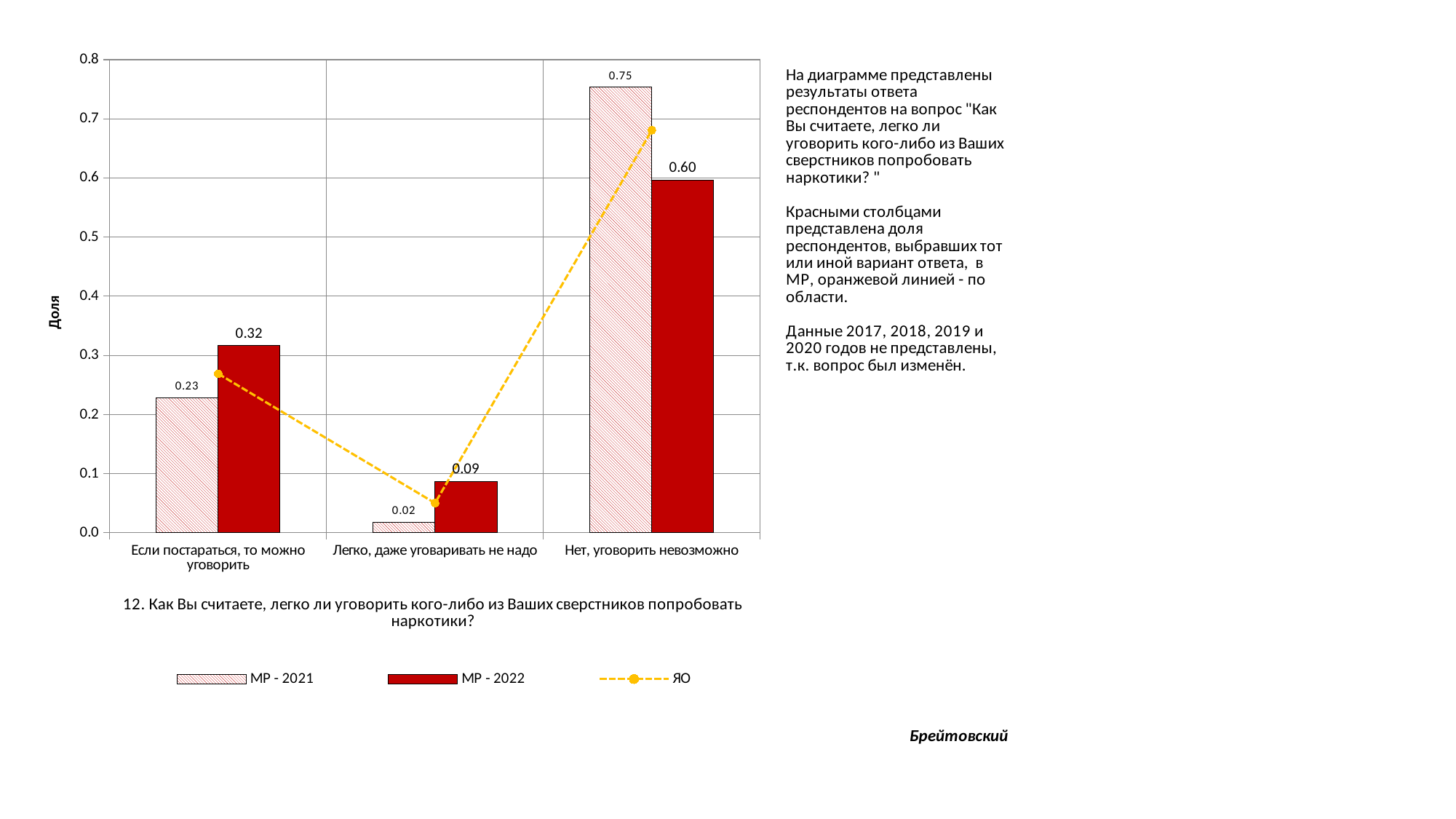
Is the ЯО value for "Нет, уговорить невозможно" greater or less than 0.6? greater How many categories are shown on the x axis? 3 What is the value for МР - 2021 in the category "Нет, уговорить невозможно"? 0.75 What is the difference between the МР - 2021 and МР - 2022 values in the category "Нет, уговорить невозможно"? 0.15 What is the value for МР - 2022 in the category "Если постараться, то можно уговорить"? 0.32 What is the label of the y axis? Доля How many series does the legend list? 3 In the category "Если постараться, то можно уговорить", which is larger: МР - 2021 or МР - 2022? МР - 2022 Which category has the highest value for МР - 2022? Нет, уговорить невозможно What is the value for МР - 2021 in the category "Легко, даже уговаривать не надо"? 0.02 Is the ЯО value for "Легко, даже уговаривать не надо" greater or less than 0.1? less Which category has the lowest value for МР - 2021? Легко, даже уговаривать не надо